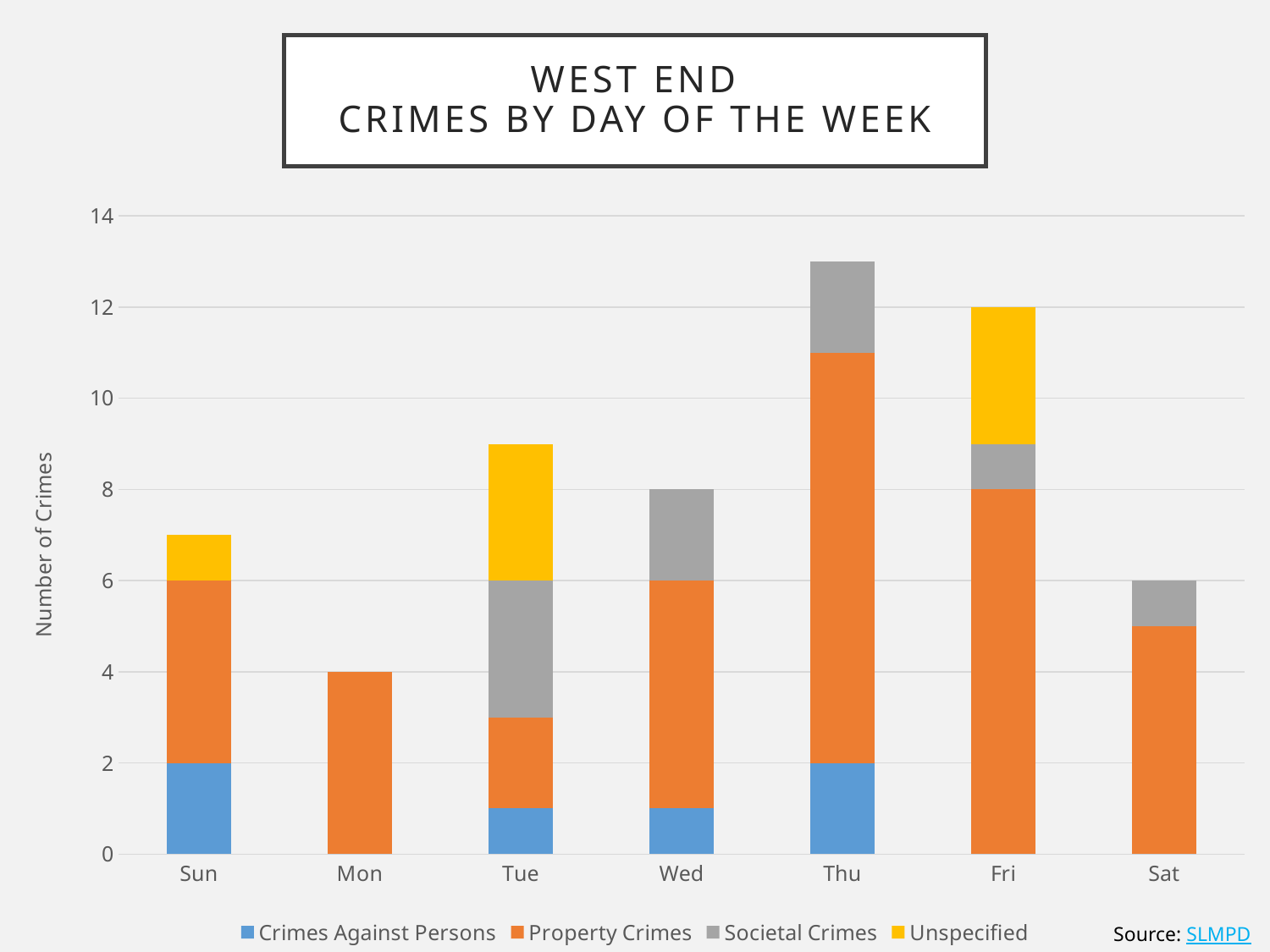
What is the total number of crimes on Sat? 6 Which day has more total crimes, Wed or Fri? Fri Which day has the lowest total number of crimes? Mon Which colour represents Unspecified crimes in the legend? Yellow Is the total number of crimes on Thu greater or less than 12? greater Is the total number of crimes on Sun greater or less than 8? less How many series does the legend list? 4 What is the total number of crimes on Mon? 4 Which day has the highest total number of crimes? Thu How many days of the week are shown on the x axis? 7 What is the total number of crimes on Fri? 12 What kind of chart is shown on the slide? Stacked bar chart